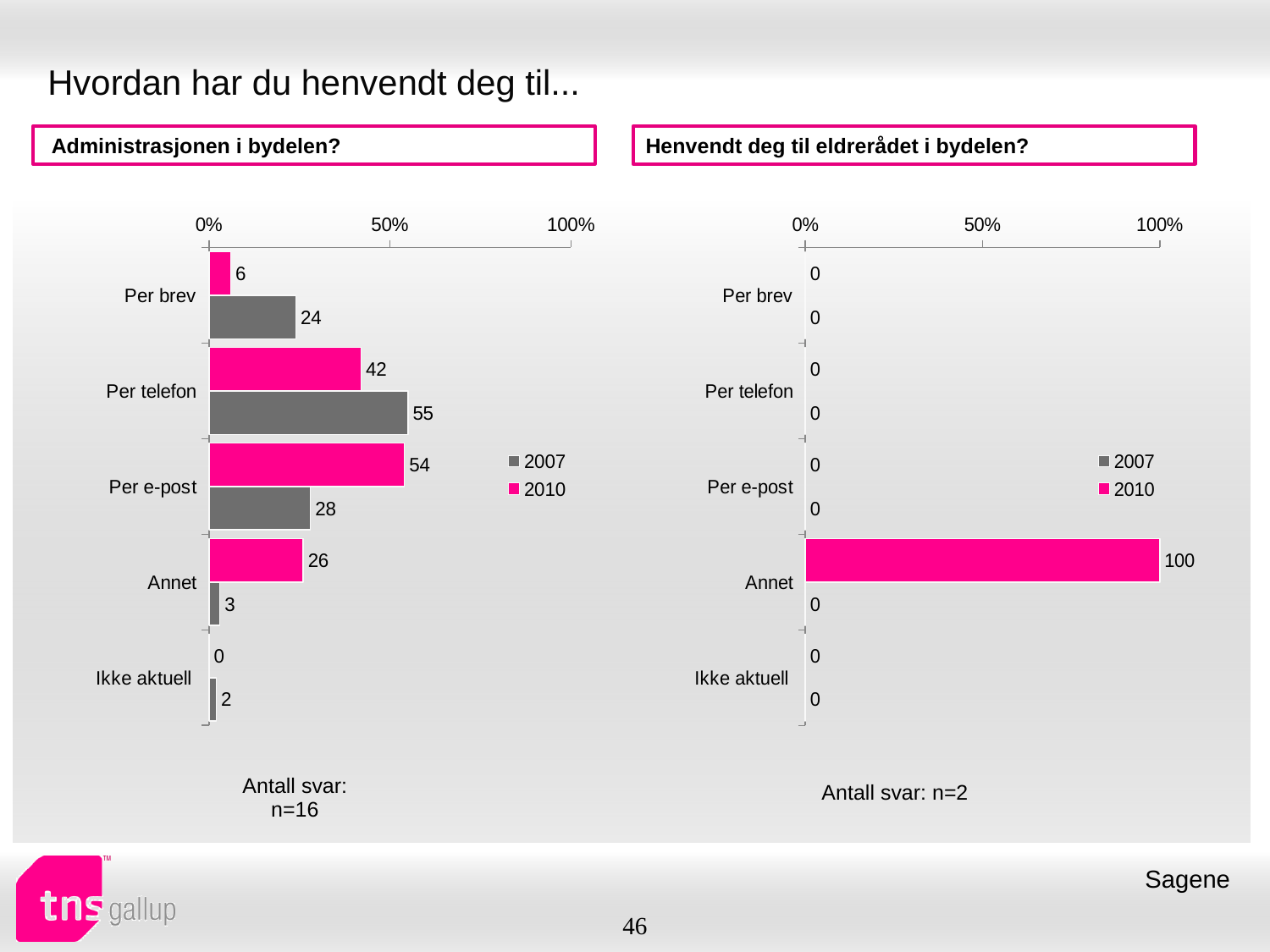
In the chart 'Administrasjonen i bydelen?', which is larger for Annet: the 2007 value or the 2010 value? 2010 In the chart 'Henvendt deg til eldrerådet i bydelen?', what is the value for Annet in 2010? 100 In the chart 'Administrasjonen i bydelen?', which category has the highest value for 2010? Per e-post In the chart 'Administrasjonen i bydelen?', what is the difference between the 2007 and 2010 values for Per brev? 18 How many series does the legend list in the chart 'Henvendt deg til eldrerådet i bydelen?'? 2 In the chart 'Administrasjonen i bydelen?', which category has the lowest value for 2007? Ikke aktuell In the chart 'Henvendt deg til eldrerådet i bydelen?', what is the number of responses (Antall svar) shown below the chart? n=2 How many categories are shown in the chart 'Administrasjonen i bydelen?'? 5 In the chart 'Administrasjonen i bydelen?', what is the value for Per telefon in 2007? 55 What kind of chart is 'Henvendt deg til eldrerådet i bydelen?'? Bar chart In the chart 'Administrasjonen i bydelen?', is the 2007 value for Per telefon greater or less than 50%? greater In the chart 'Administrasjonen i bydelen?', what is the value for Per e-post in 2010? 54